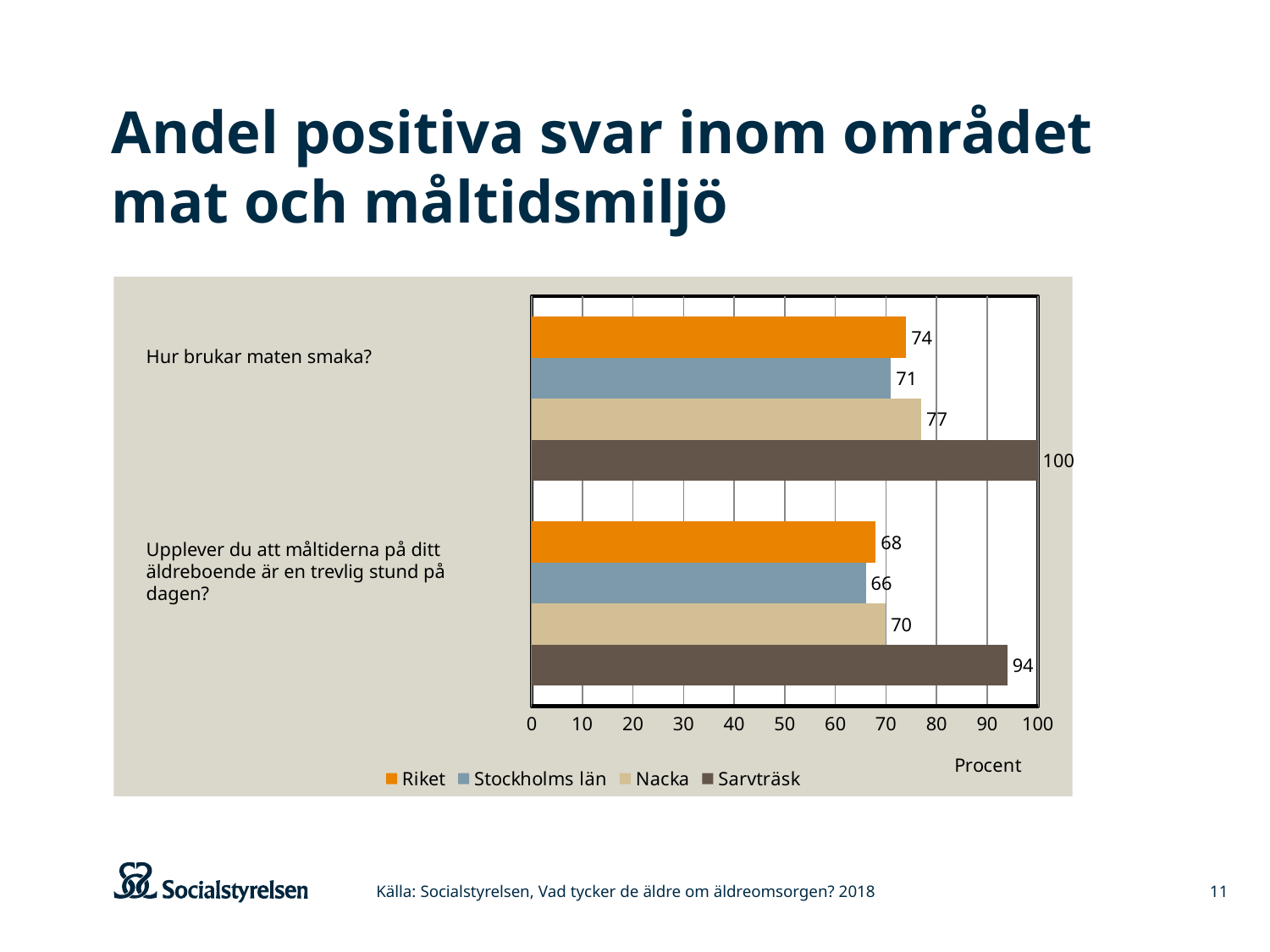
What is the value for Stockholms län for the question "Upplever du att måltiderna på ditt äldreboende är en trevlig stund på dagen?"? 66 What is the value for Nacka for the question "Hur brukar maten smaka?"? 77 Which series has the highest value for the question "Hur brukar maten smaka?"? Sarvträsk Which is larger: the Riket value for "Hur brukar maten smaka?" or the Riket value for "Upplever du att måltiderna på ditt äldreboende är en trevlig stund på dagen?"? Hur brukar maten smaka? What is the difference between the Nacka and Stockholms län values for the question "Upplever du att måltiderna på ditt äldreboende är en trevlig stund på dagen?"? 4 What is the value for Riket for the question "Upplever du att måltiderna på ditt äldreboende är en trevlig stund på dagen?"? 68 What is the label on the horizontal axis of the chart? Procent What is the value for Sarvträsk for the question "Hur brukar maten smaka?"? 100 Which series has the lowest value for the question "Upplever du att måltiderna på ditt äldreboende är en trevlig stund på dagen?"? Stockholms län What kind of chart is shown on the slide? Bar chart What is the difference between the Sarvträsk and Riket values for the question "Hur brukar maten smaka?"? 26 How many series does the legend list? 4